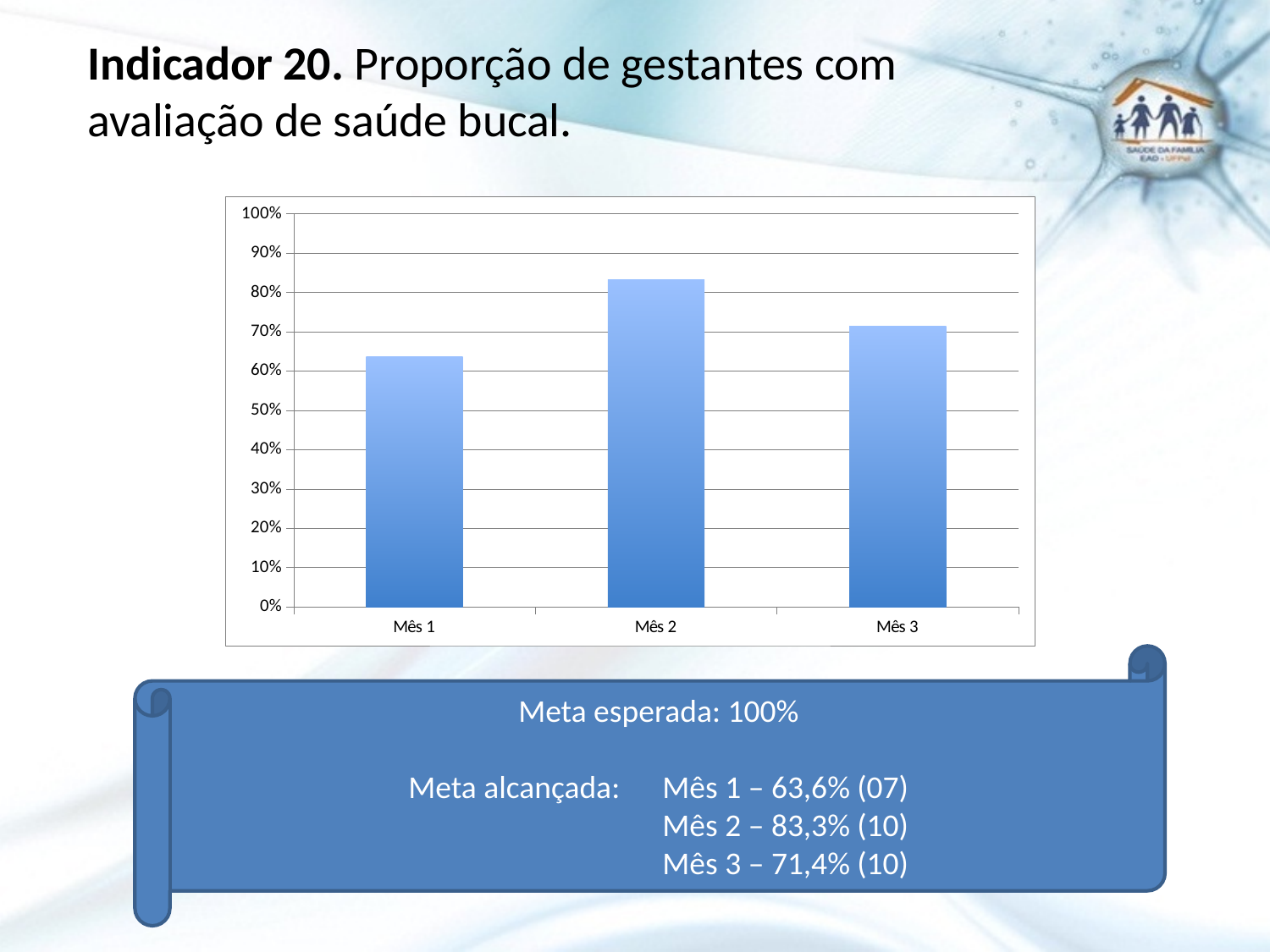
How many categories (months) are plotted on the chart? 3 Is the value for Mês 2 greater or less than 80%? greater What is the value for Mês 3? 71,4% What is the value for Mês 1? 63,6% Which month has the lowest bar on the chart? Mês 1 Is the value for Mês 1 greater or less than 70%? less What is the difference between the values for Mês 2 and Mês 1? 19,7% Which month has the highest bar on the chart? Mês 2 Do the values rise or fall from Mês 2 to Mês 3? fall What is the value for Mês 2? 83,3% What kind of chart is shown on the slide? Bar chart Which is larger, the value for Mês 3 or the value for Mês 1? Mês 3